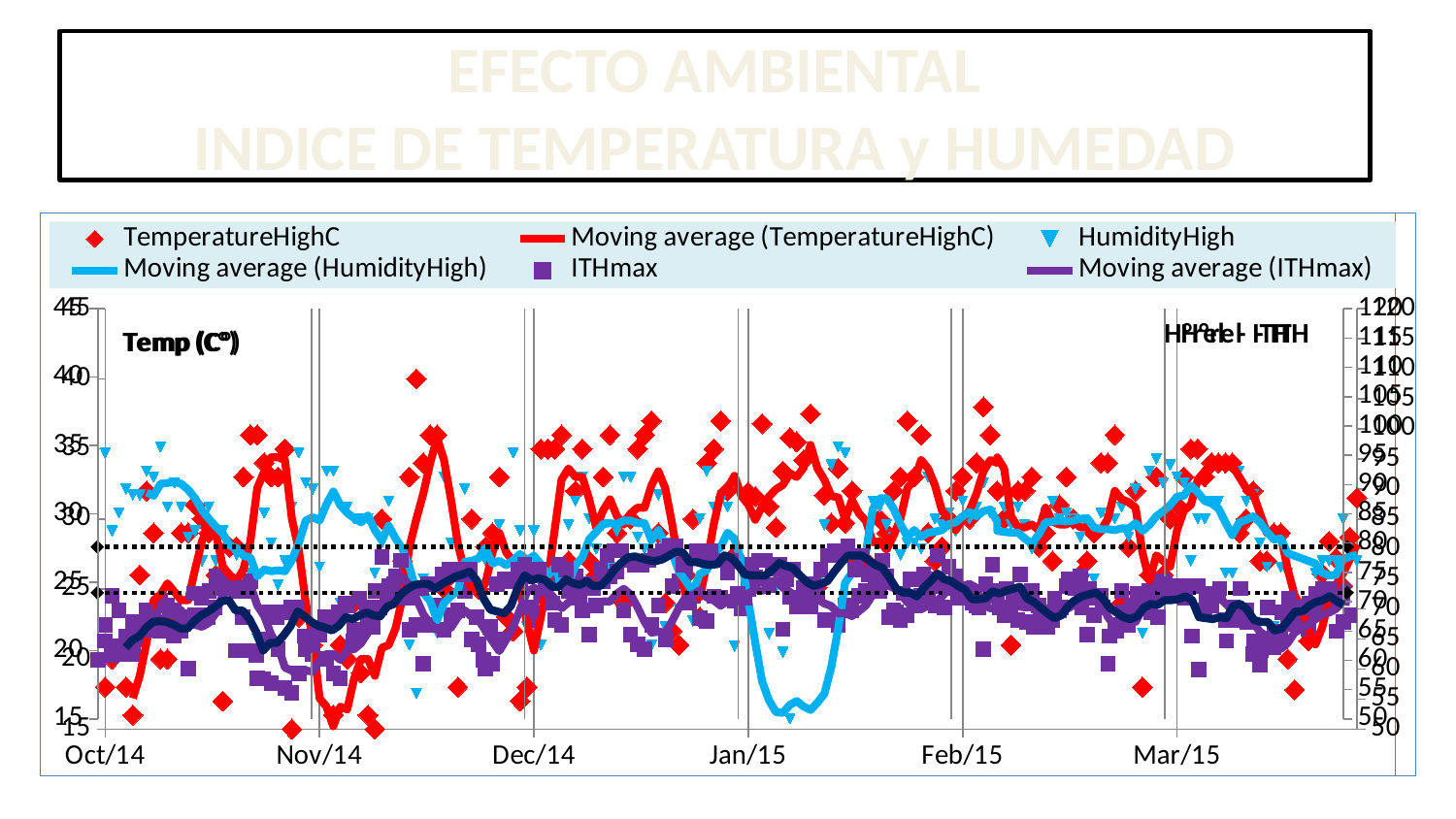
How many month labels are shown along the x axis? 6 Are the lowest TemperatureHighC points, plotted around Nov/14, greater or less than 20 on the left axis? less Is the peak of the Moving average (TemperatureHighC) line in mid-November 2014 greater or less than 30 on the left axis? greater What is the last month label on the x axis? Mar/15 Is the highest TemperatureHighC point, plotted in mid-November 2014, greater or less than 35 on the left axis? greater What is the first month label on the x axis? Oct/14 Does the Moving average (ITHmax) line rise or fall between Oct/14 and Dec/14? rise How many series does the legend list? 6 What kind of chart is shown on the slide? scatter chart with moving average lines Does the Moving average (ITHmax) line rise or fall between Jan/15 and Mar/15? fall